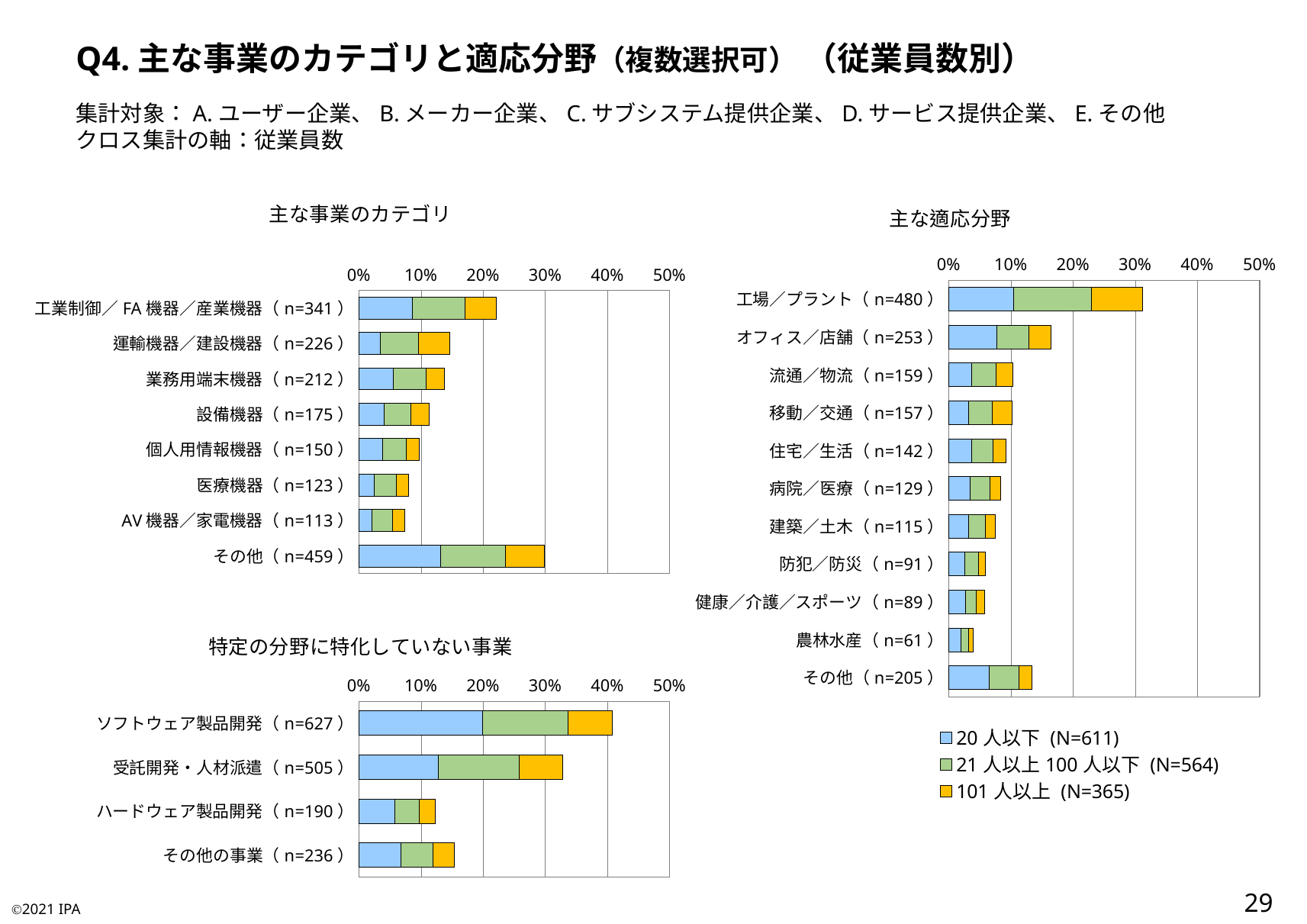
How many categories are shown in the "主な適応分野" chart? 11 In the "特定の分野に特化していない事業" chart, which category has the shortest total bar? ハードウェア製品開発 (n=190) How many series does the legend list? 3 Which series does the orange colour represent in the legend? 101人以上 (N=365) In the "主な事業のカテゴリ" chart, which category has the longest total bar? その他 (n=459) In the "主な適応分野" chart, which category has the longest total bar? 工場／プラント (n=480) In the "主な適応分野" chart, which category has the shortest total bar? 農林水産 (n=61) How many categories are shown in the "特定の分野に特化していない事業" chart? 4 In the "主な適応分野" chart, is the total value for オフィス／店舗 greater or less than 20%? less What kind of chart is the "主な事業のカテゴリ" chart? Stacked bar chart In the "主な事業のカテゴリ" chart, is the total value for 工業制御／FA機器／産業機器 greater or less than 20%? greater In the "主な事業のカテゴリ" chart, which category has the shortest total bar? AV機器／家電機器 (n=113)